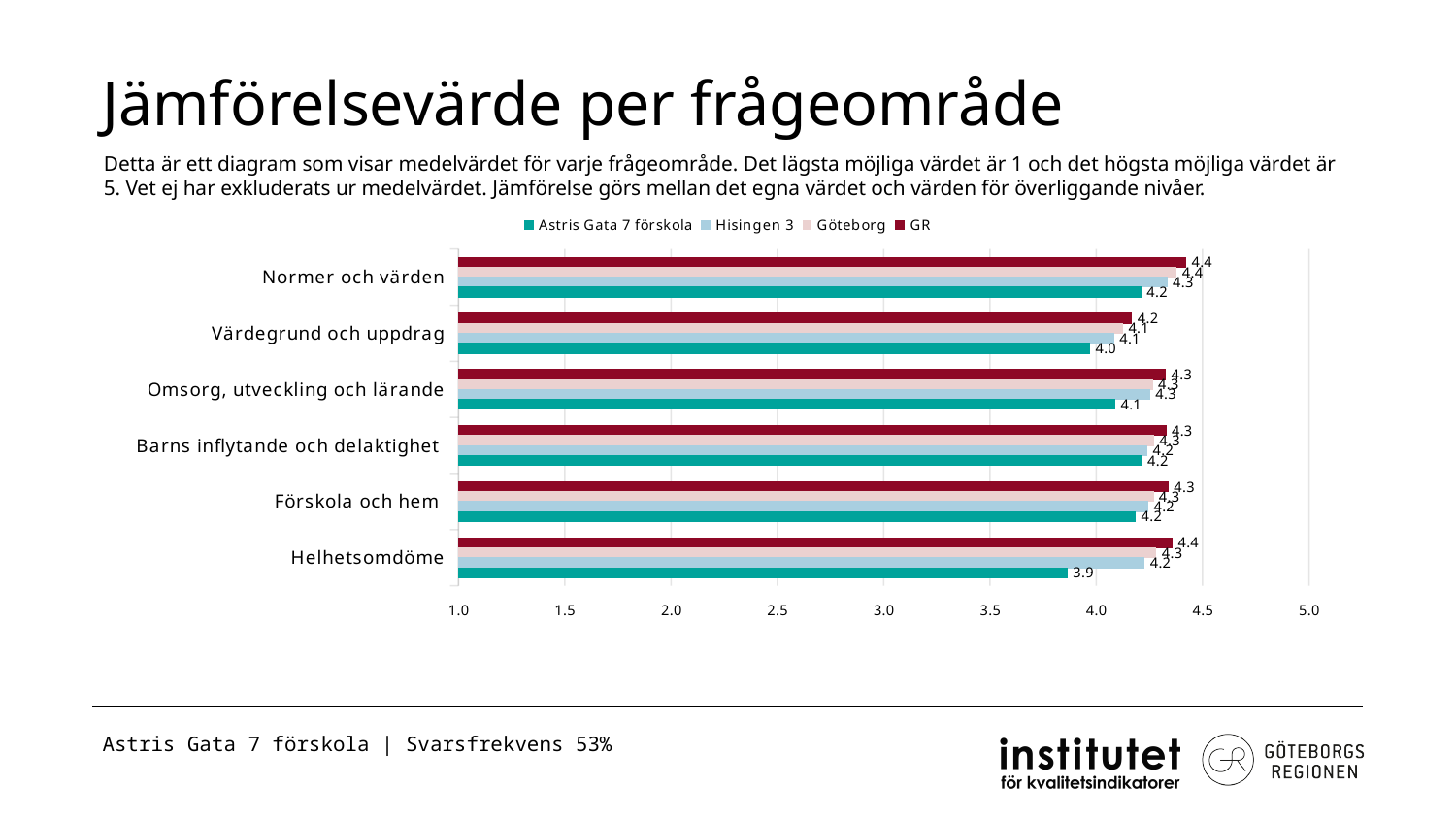
What is the value for Hisingen 3 in Omsorg, utveckling och lärande? 4.3 In which question area does Astris Gata 7 förskola have its lowest value? Helhetsomdöme What kind of chart is shown on the slide? bar chart What is the value for GR in Normer och värden? 4.4 Which series is shown in dark red in the legend? GR How many series does the legend list? 4 Which is larger in Värdegrund och uppdrag: the value for GR or the value for Astris Gata 7 förskola? GR Is the value for Astris Gata 7 förskola in Helhetsomdöme greater or less than 4.0? less What is the difference between GR and Astris Gata 7 förskola in Helhetsomdöme? 0.5 What is the value for Astris Gata 7 förskola in Helhetsomdöme? 3.9 How many question areas (categories) are shown on the y axis? 6 What is the value for Astris Gata 7 förskola in Värdegrund och uppdrag? 4.0